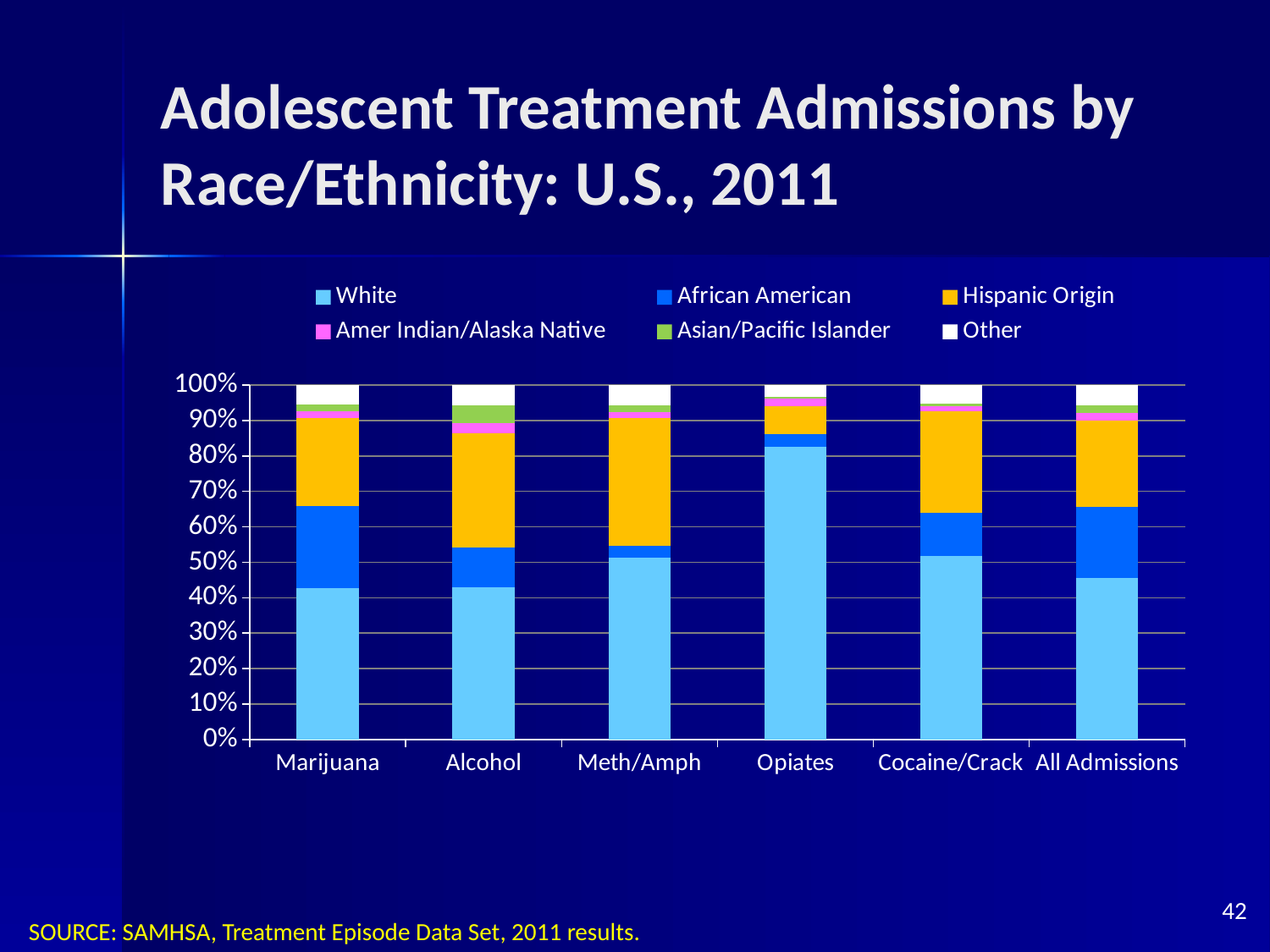
Which legend entry is shown in white? Other Which has a larger White share of admissions, Opiates or Alcohol? Opiates Which category has the smallest Hispanic Origin share of admissions? Opiates Is the White share of admissions for Opiates greater or less than 70%? greater Which category has the largest White share of admissions? Opiates How many substance categories are shown along the x axis? 6 Which has a larger African American share of admissions, Marijuana or Meth/Amph? Marijuana What is the title of the slide's chart? Adolescent Treatment Admissions by Race/Ethnicity: U.S., 2011 Which category has the largest African American share of admissions? Marijuana How many race/ethnicity series does the legend list? 6 What kind of chart is shown on the slide? Stacked bar chart Is the White share of admissions for Marijuana greater or less than 50%? less